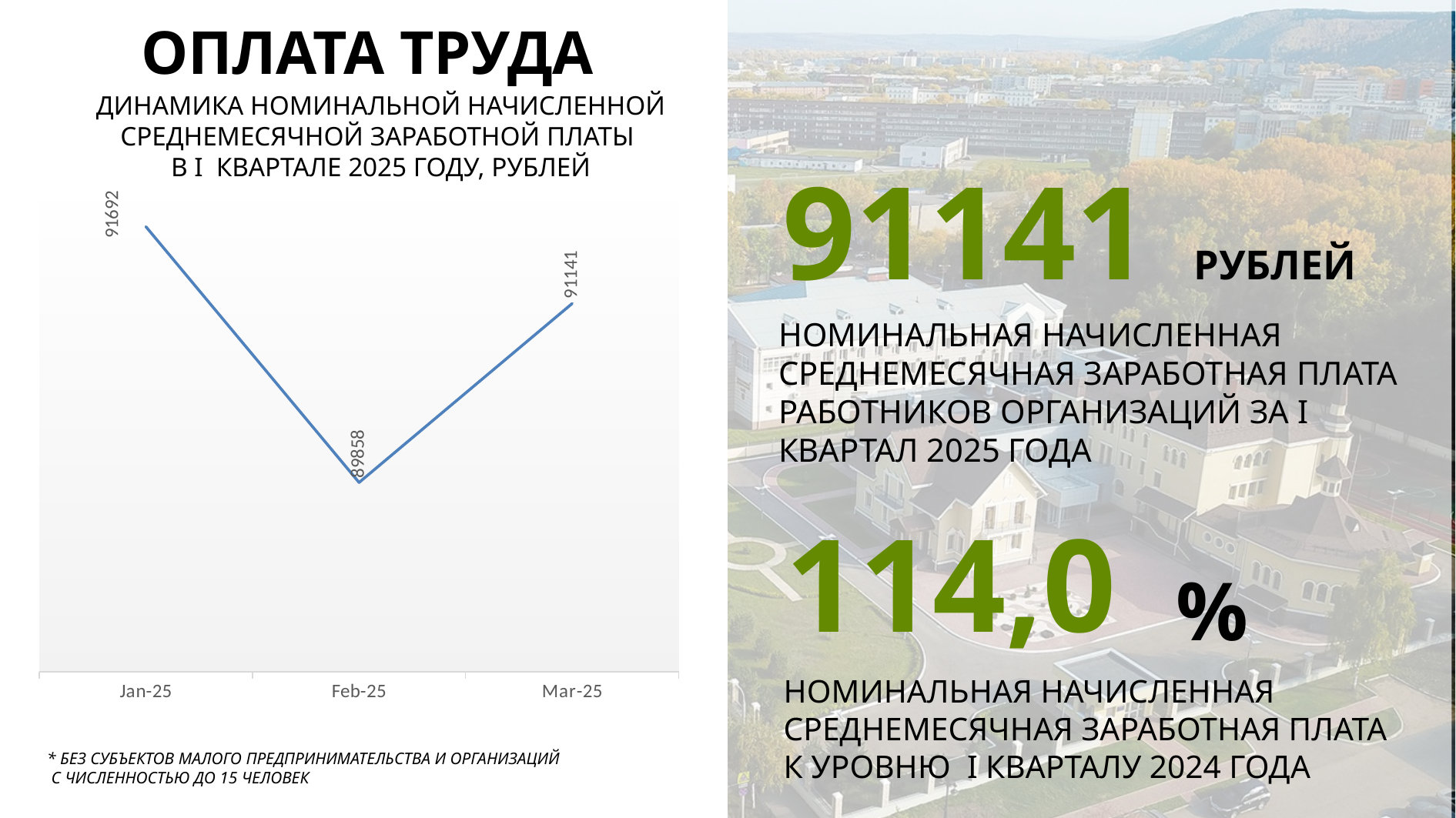
Which month has the highest value? Jan-25 What is the value for Jan-25? 91692 What is the difference between the values for Mar-25 and Feb-25? 1283 What type of chart is shown on the slide? line chart What is the value for Mar-25? 91141 Which is larger, the value for Jan-25 or the value for Mar-25? Jan-25 What is the value for Feb-25? 89858 How many data points are plotted on the chart? 3 Which month has the lowest value? Feb-25 What is the difference between the values for Jan-25 and Feb-25? 1834 What unit is stated in the chart title? рублей Does the value rise or fall from Jan-25 to Feb-25? fall